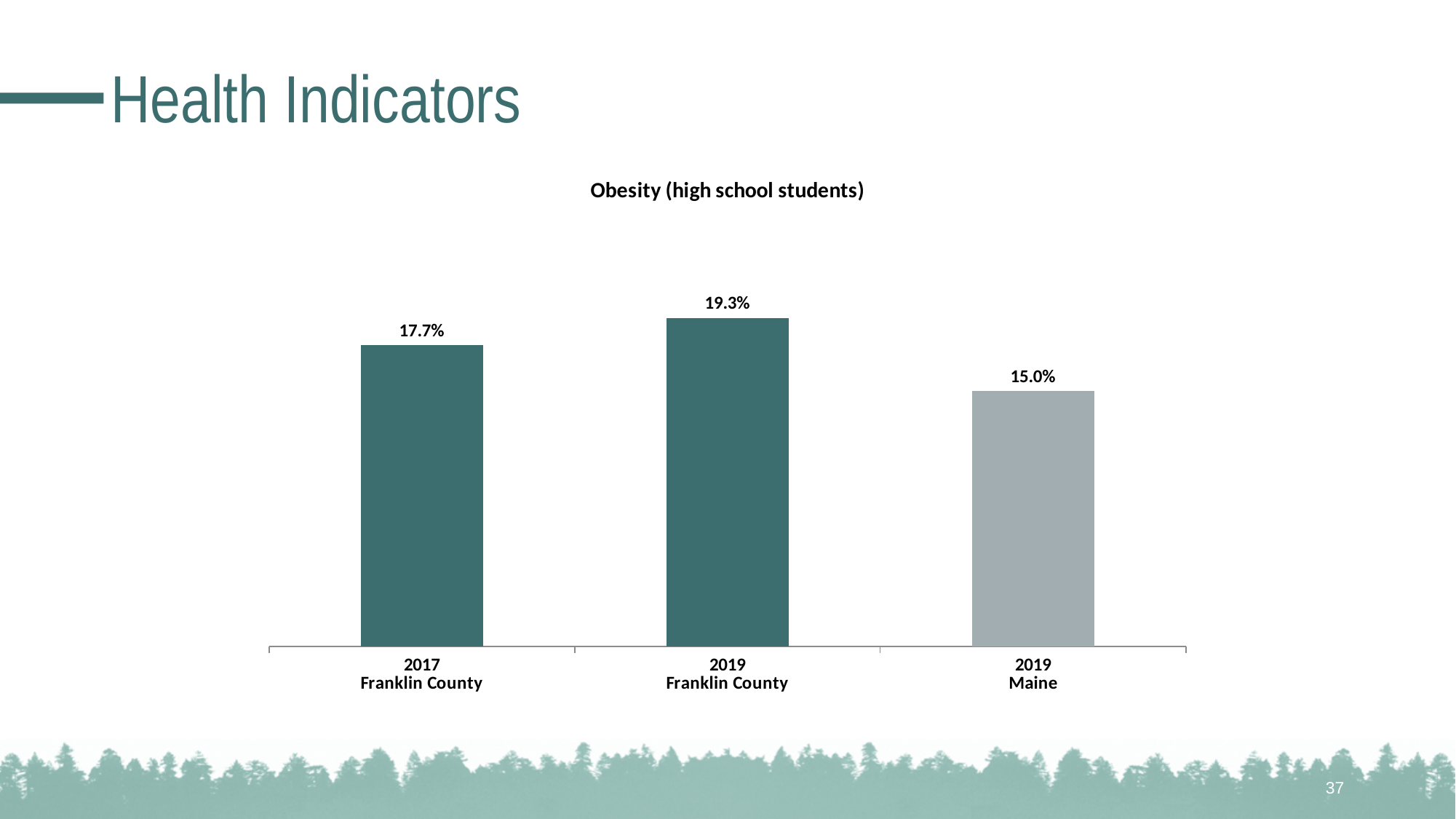
Which category has the highest obesity rate? 2019 Franklin County What is the difference between the 2019 and 2017 Franklin County obesity rates? 1.6% What is the difference between the 2019 Franklin County and 2019 Maine obesity rates? 4.3% What is the obesity rate for high school students in Maine in 2019? 15.0% What is the title of the chart? Obesity (high school students) What kind of chart is shown on the slide? Bar chart How many bars are shown in the chart? 3 Did the Franklin County obesity rate rise or fall from 2017 to 2019? Rise What is the obesity rate for high school students in Franklin County in 2017? 17.7% Which is larger, the 2017 Franklin County rate or the 2019 Maine rate? 2017 Franklin County Which category has the lowest obesity rate? 2019 Maine What is the obesity rate for high school students in Franklin County in 2019? 19.3%